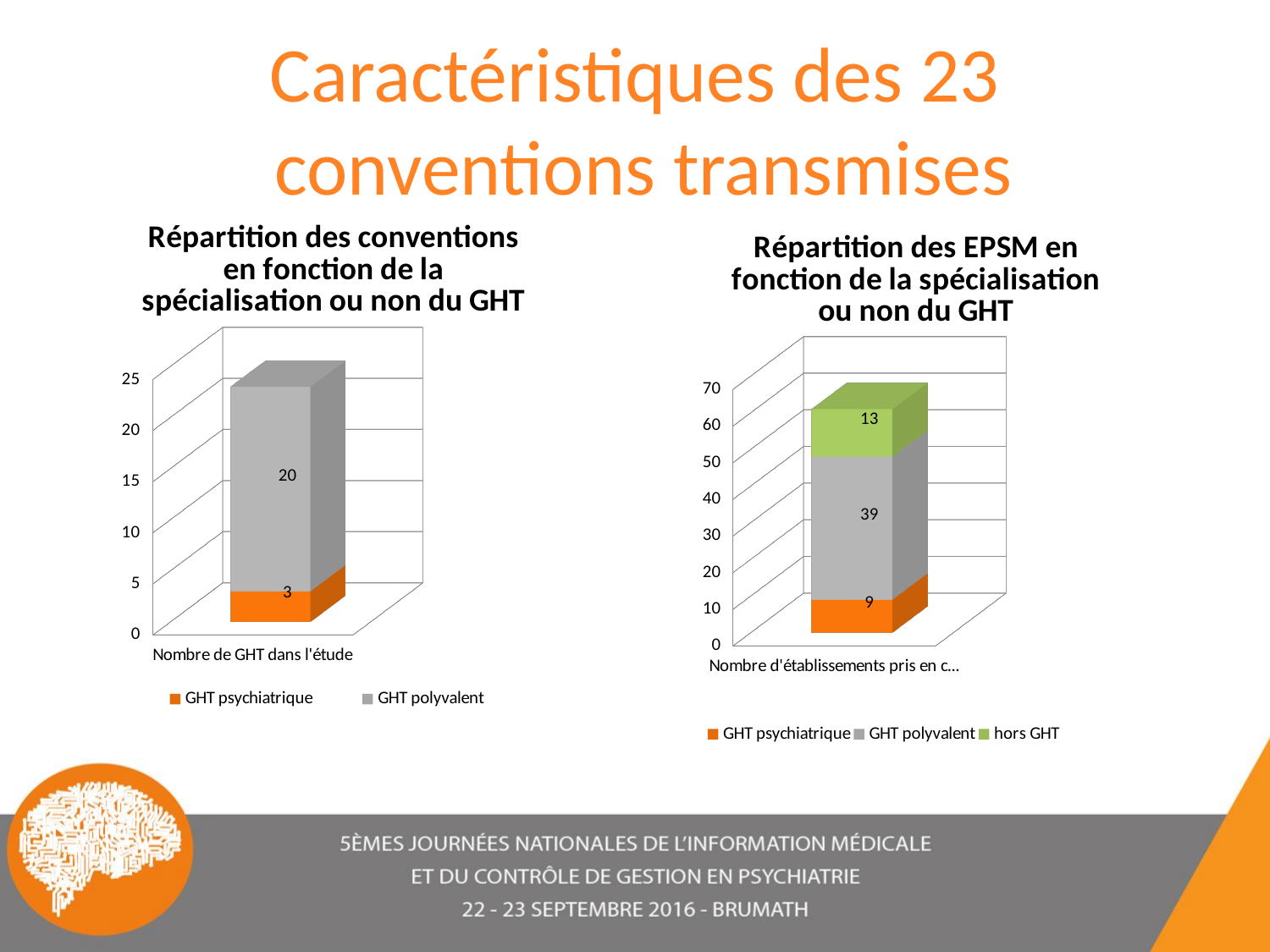
In the right chart 'Répartition des EPSM en fonction de la spécialisation ou non du GHT', what is the total of the stacked bar? 61 In the right chart 'Répartition des EPSM en fonction de la spécialisation ou non du GHT', what is the value for GHT polyvalent? 39 In the left chart 'Répartition des conventions en fonction de la spécialisation ou non du GHT', what is the value for GHT psychiatrique? 3 In the left chart 'Répartition des conventions en fonction de la spécialisation ou non du GHT', what is the total of the stacked bar? 23 In the right chart 'Répartition des EPSM en fonction de la spécialisation ou non du GHT', what is the difference between GHT polyvalent and hors GHT? 26 In the left chart 'Répartition des conventions en fonction de la spécialisation ou non du GHT', what is the value for GHT polyvalent? 20 What kind of chart is the left chart 'Répartition des conventions en fonction de la spécialisation ou non du GHT'? Stacked bar chart In the right chart 'Répartition des EPSM en fonction de la spécialisation ou non du GHT', which series has the highest value? GHT polyvalent In the right chart 'Répartition des EPSM en fonction de la spécialisation ou non du GHT', how many series does the legend list? 3 In the right chart 'Répartition des EPSM en fonction de la spécialisation ou non du GHT', what is the value for hors GHT? 13 In the left chart 'Répartition des conventions en fonction de la spécialisation ou non du GHT', how many series does the legend list? 2 In the right chart 'Répartition des EPSM en fonction de la spécialisation ou non du GHT', what is the value for GHT psychiatrique? 9